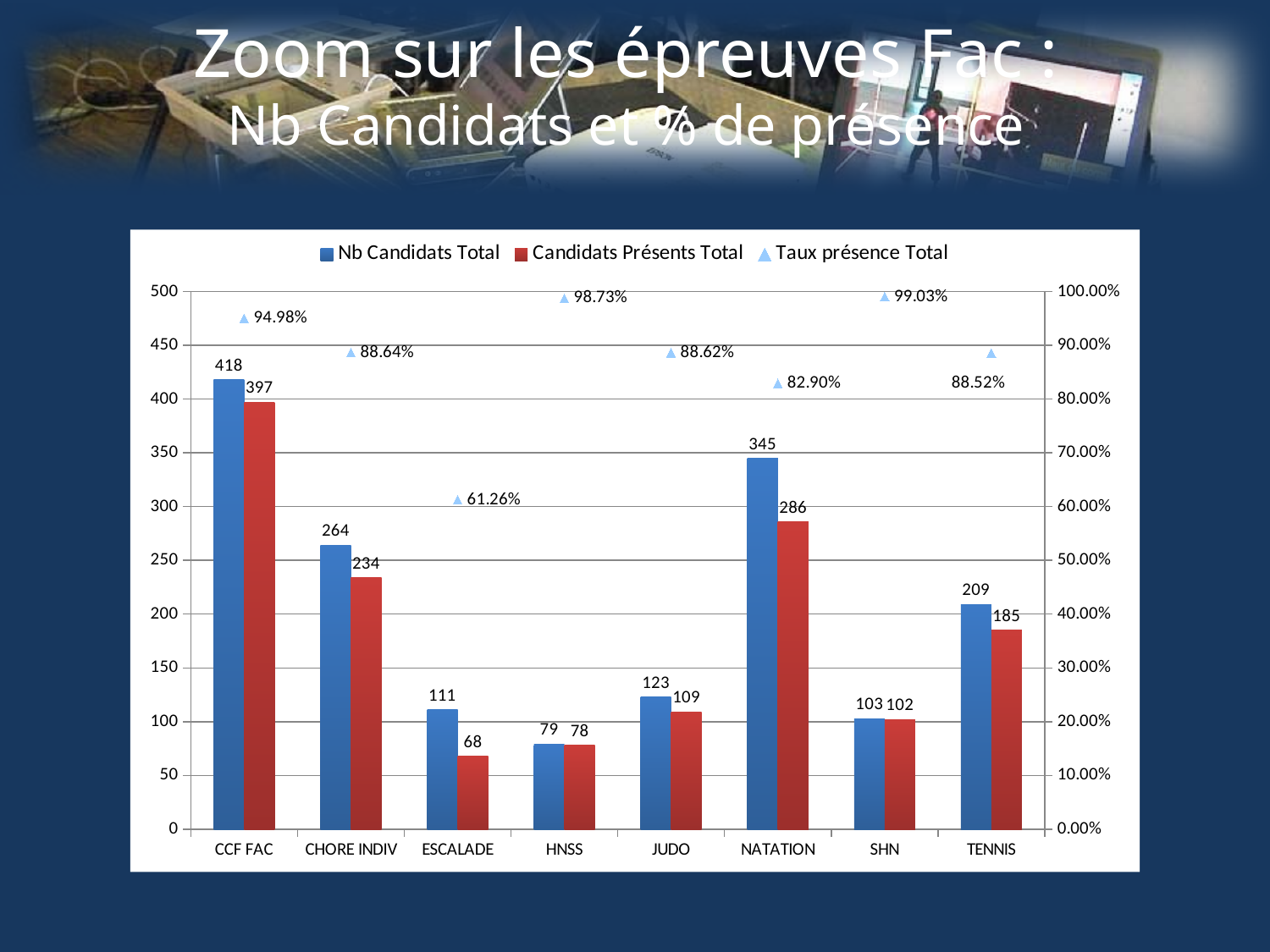
What is the difference between Nb Candidats Total and Candidats Présents Total for TENNIS? 24 Which category has the highest Nb Candidats Total? CCF FAC What is the value of Candidats Présents Total for CHORE INDIV? 234 What kind of chart is used for the Nb Candidats Total and Candidats Présents Total series? Bar chart What is the Taux présence Total for ESCALADE? 61.26% What colour are the Candidats Présents Total bars? Red How many categories are shown on the x axis? 8 Which is larger: Candidats Présents Total for JUDO or for SHN? JUDO What is the Taux présence Total for SHN? 99.03% Which category has the lowest Taux présence Total? ESCALADE How many series does the legend list? 3 What is the value of Nb Candidats Total for NATATION? 345